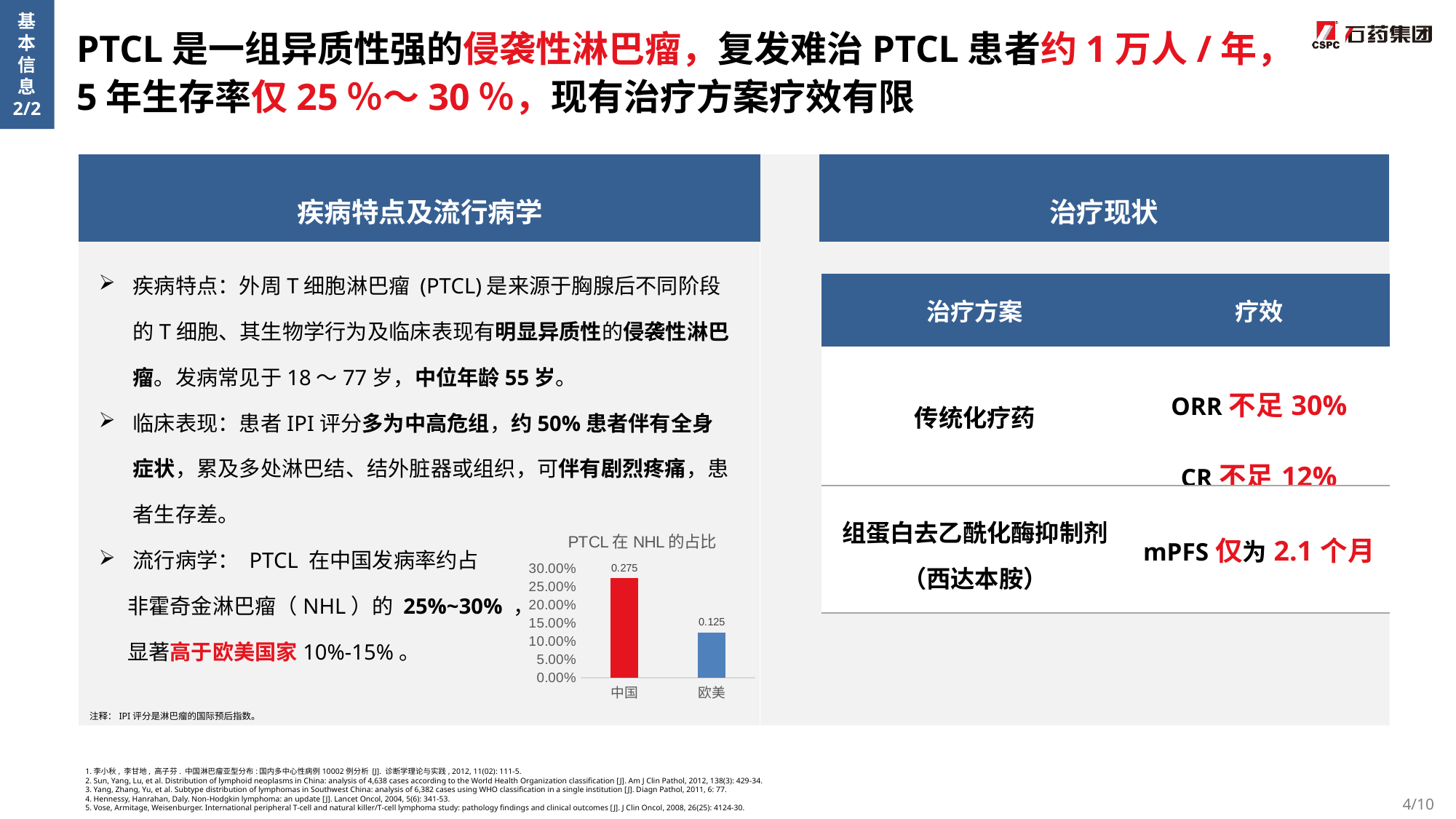
In the chart PTCL 在 NHL 的占比, is the bar for 欧美 greater or less than 15.00% on the axis? less What is the highest tick value shown on the vertical axis of the chart PTCL 在 NHL 的占比? 30.00% In the chart PTCL 在 NHL 的占比, which is larger, the value for 中国 or the value for 欧美? 中国 In the chart PTCL 在 NHL 的占比, which category has the highest value? 中国 What is the data label shown for 中国 in the chart titled PTCL 在 NHL 的占比? 0.275 What is the data label shown for 欧美 in the chart titled PTCL 在 NHL 的占比? 0.125 In the chart PTCL 在 NHL 的占比, what is the difference between the data labels for 中国 and 欧美? 0.15 What is the title of the chart on the slide? PTCL 在 NHL 的占比 How many categories are shown in the chart PTCL 在 NHL 的占比? 2 In the chart PTCL 在 NHL 的占比, is the bar for 中国 greater or less than 20.00% on the axis? greater In the chart PTCL 在 NHL 的占比, which category has the lowest value? 欧美 What kind of chart is PTCL 在 NHL 的占比? bar chart